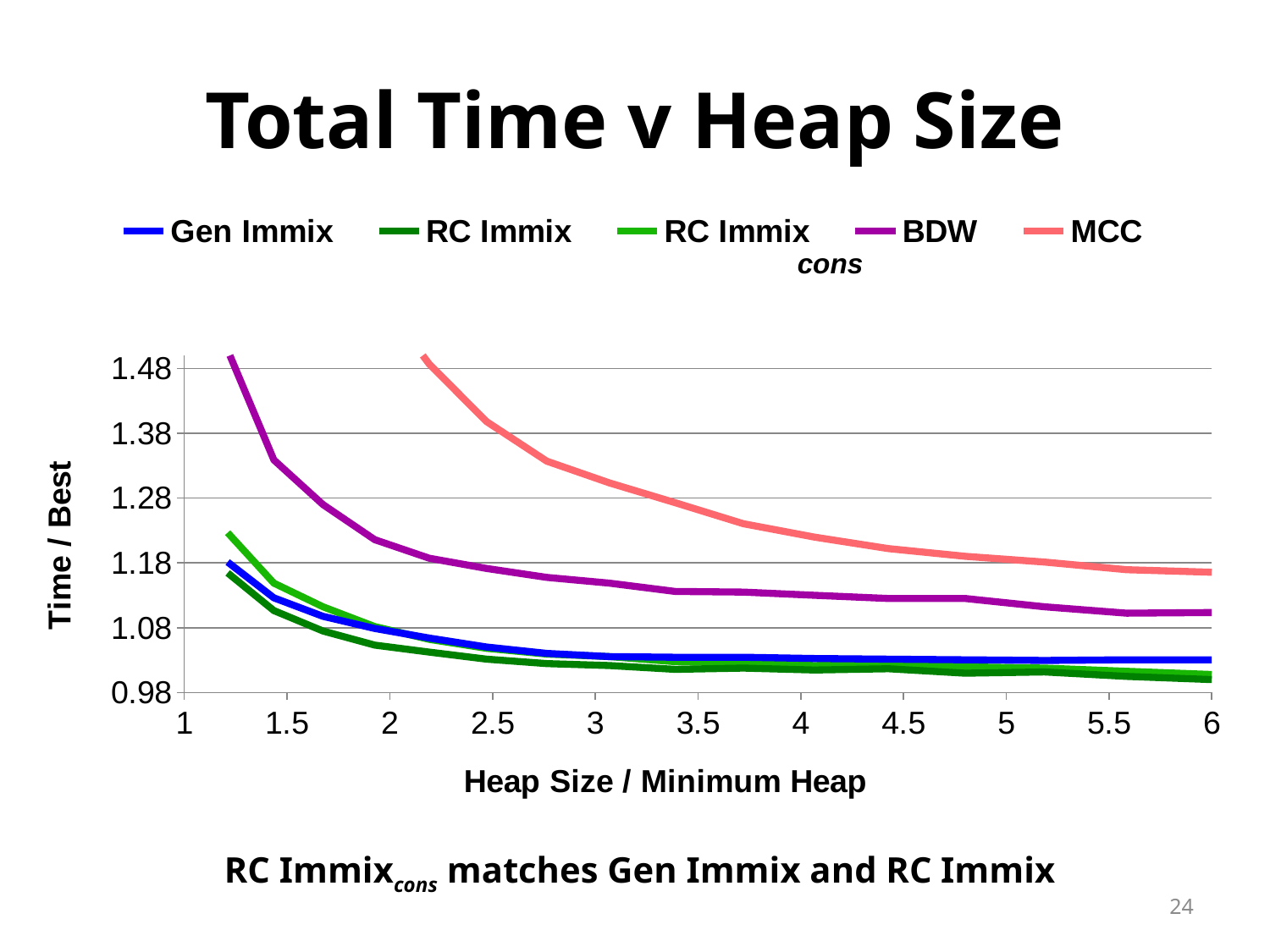
At a heap size of 4, which is larger, BDW or Gen Immix? BDW What kind of chart is shown on the slide? line chart Do the Time / Best values rise or fall as heap size increases? fall Which series has the highest Time / Best at a heap size of 3? MCC What is the label of the y axis? Time / Best Is the value for BDW at a heap size of 2 greater or less than 1.18? greater What is the title of the chart? Total Time v Heap Size How many series does the legend list? 5 Is the value for Gen Immix at a heap size of 6 greater or less than 1.08? less Is the value for MCC at a heap size of 3 greater or less than 1.28? greater At a heap size of 3, which is larger, MCC or BDW? MCC